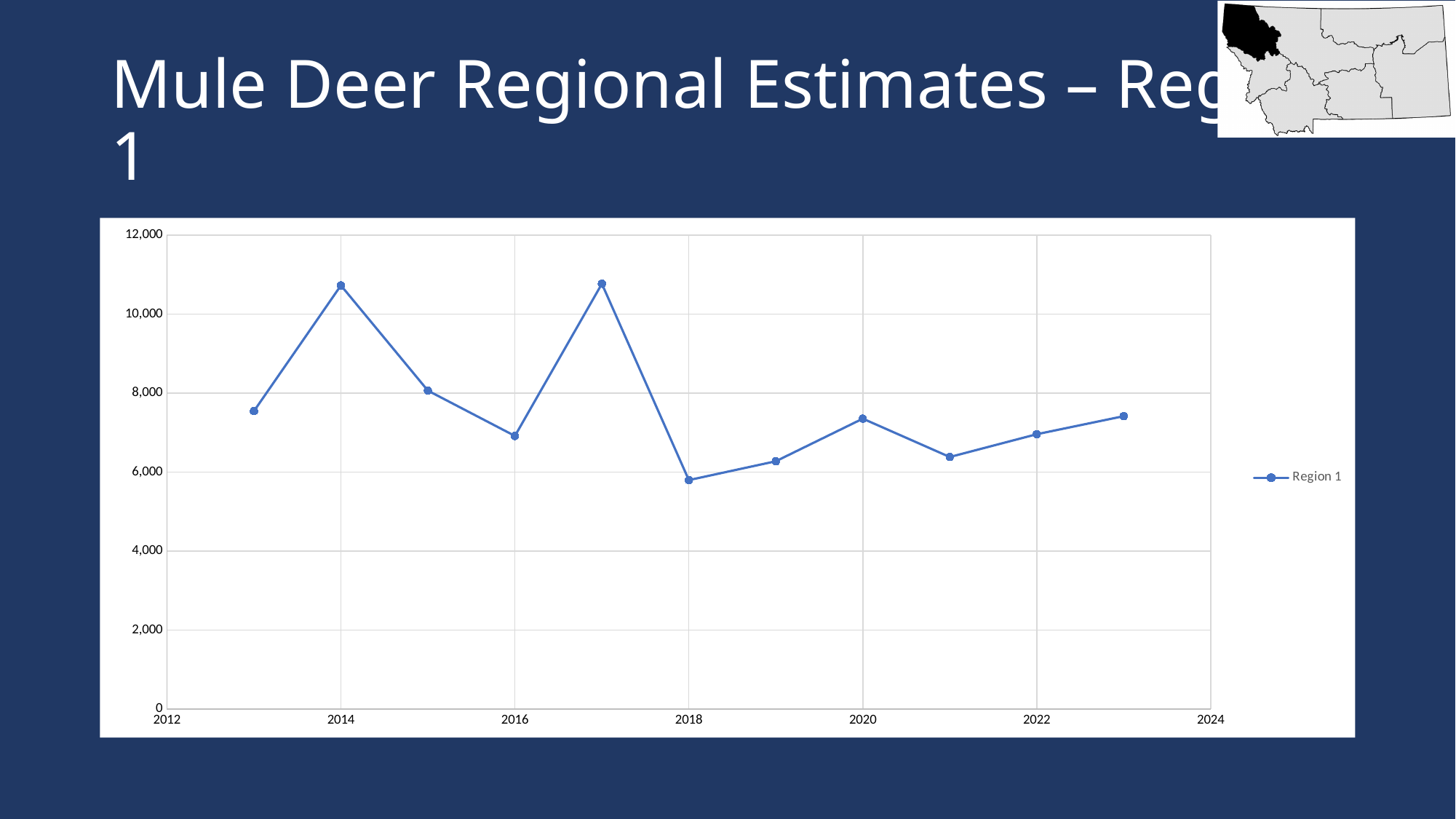
Is the value for 2016 greater or less than 6,000? greater What is the name of the series shown in the legend? Region 1 What kind of chart is shown on the slide? line chart Is the value for 2013 greater or less than 8,000? less Is the value for 2014 greater or less than 10,000? greater Does the Region 1 line rise or fall from 2018 to 2020? rise In which year is the Region 1 estimate lowest? 2018 How many data points are plotted on the Region 1 line? 11 Which year has the larger value, 2018 or 2020? 2020 How many series does the legend list? 1 Which year has the larger value, 2014 or 2016? 2014